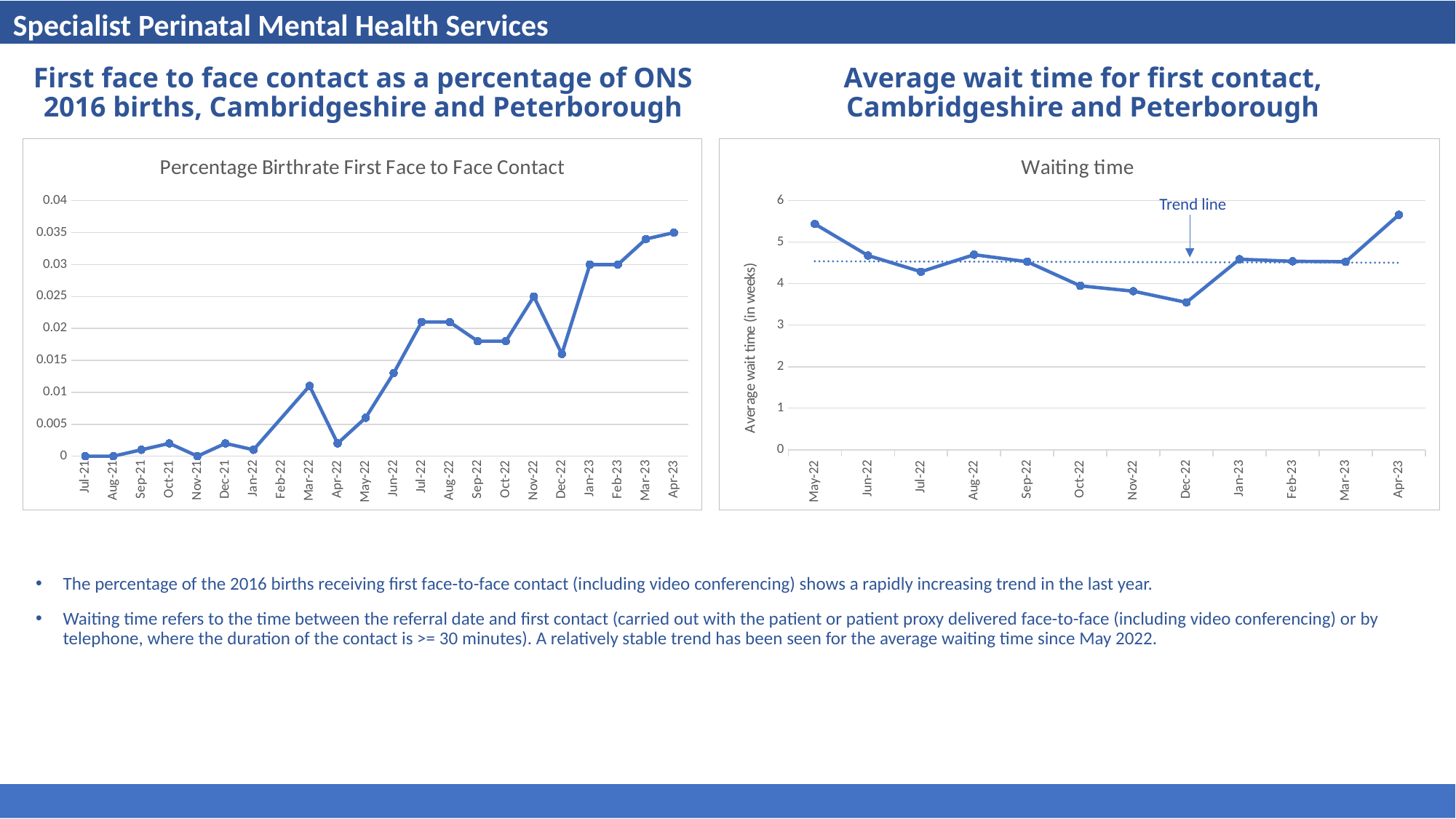
What is the y-axis label of the 'Waiting time' chart on the right? Average wait time (in weeks) In the 'Waiting time' chart on the right, which month has the highest average wait time? Apr-23 In the 'Percentage Birthrate First Face to Face Contact' chart on the left, do the values generally rise or fall from Jul-21 to Apr-23? Rise In the 'Waiting time' chart on the right, is the value for Dec-22 greater or less than 4? less What kind of chart is the 'Percentage Birthrate First Face to Face Contact' chart on the left? Line chart In the 'Percentage Birthrate First Face to Face Contact' chart on the left, what is the value for Apr-23? 0.035 In the 'Percentage Birthrate First Face to Face Contact' chart on the left, which is larger, the value for Mar-22 or the value for Apr-22? Mar-22 In the 'Waiting time' chart on the right, is the value for May-22 greater or less than 5? greater In the 'Percentage Birthrate First Face to Face Contact' chart on the left, what is the value for Jul-21? 0 In the 'Waiting time' chart on the right, which month has the lowest average wait time? Dec-22 In the 'Waiting time' chart on the right, how many monthly data points are plotted? 12 In the 'Percentage Birthrate First Face to Face Contact' chart on the left, which month has the highest value? Apr-23